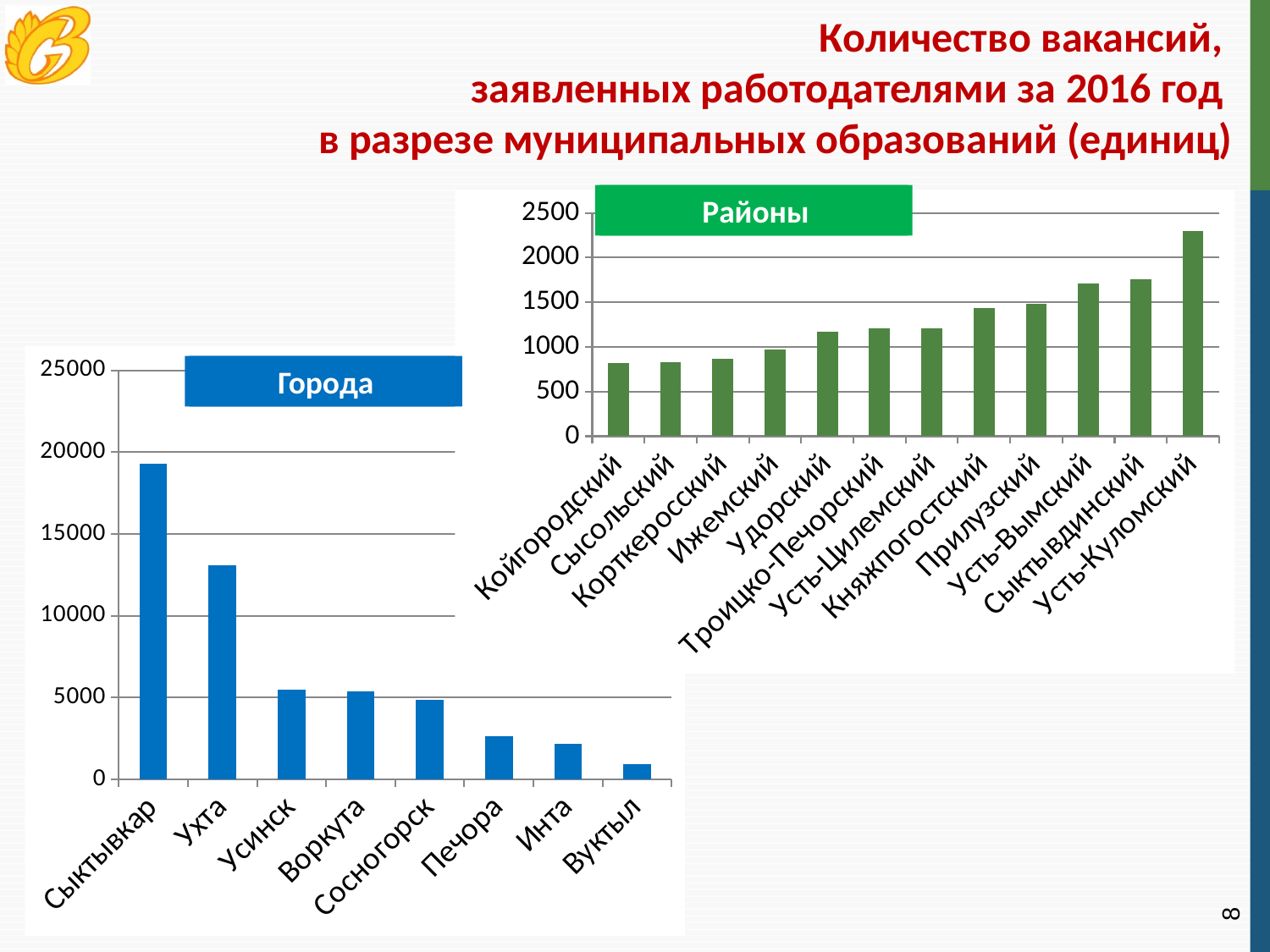
In the "Города" chart, is the value for Ухта greater or less than 10000? greater In the "Районы" chart, is the value for Койгородский greater or less than 1000? less In the "Города" chart, which city has the lowest number of vacancies? Вуктыл In the "Города" chart, is the value for Сыктывкар greater or less than 15000? greater In the "Города" chart, do the values rise or fall from left to right along the x axis? fall In the "Города" chart, how many cities are shown? 8 In the "Районы" chart, which is larger, the value for Усть-Вымский or the value for Удорский? Усть-Вымский In the "Районы" chart, which district has the highest number of vacancies? Усть-Куломский In the "Районы" chart, how many districts are shown? 12 In the "Города" chart, which city has the highest number of vacancies? Сыктывкар